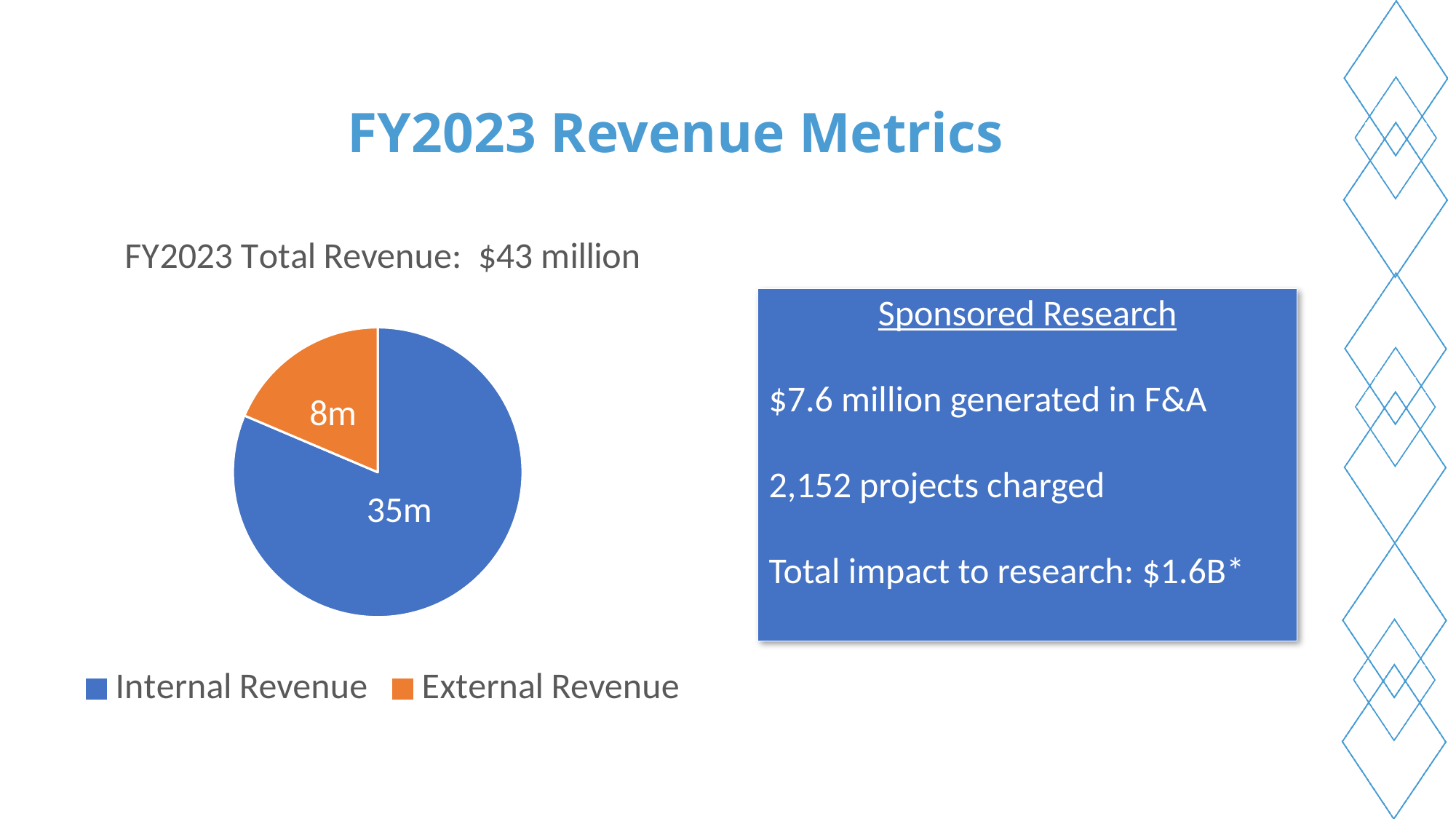
What is the title of the slide containing the pie chart? FY2023 Revenue Metrics Which category has the largest slice in the pie chart? Internal Revenue What is the difference between the Internal Revenue and External Revenue values in the pie chart? 27m Which is larger in the pie chart, Internal Revenue or External Revenue? Internal Revenue What is the value of the External Revenue slice in the pie chart? 8m What is the total revenue shown for FY2023 according to the chart heading? $43 million What is the value of the Internal Revenue slice in the pie chart? 35m What colour is the External Revenue slice in the pie chart? orange Which category has the smallest slice in the pie chart? External Revenue What type of chart is shown on the slide? pie chart How many slices does the pie chart have? 2 How many entries does the pie chart legend list? 2